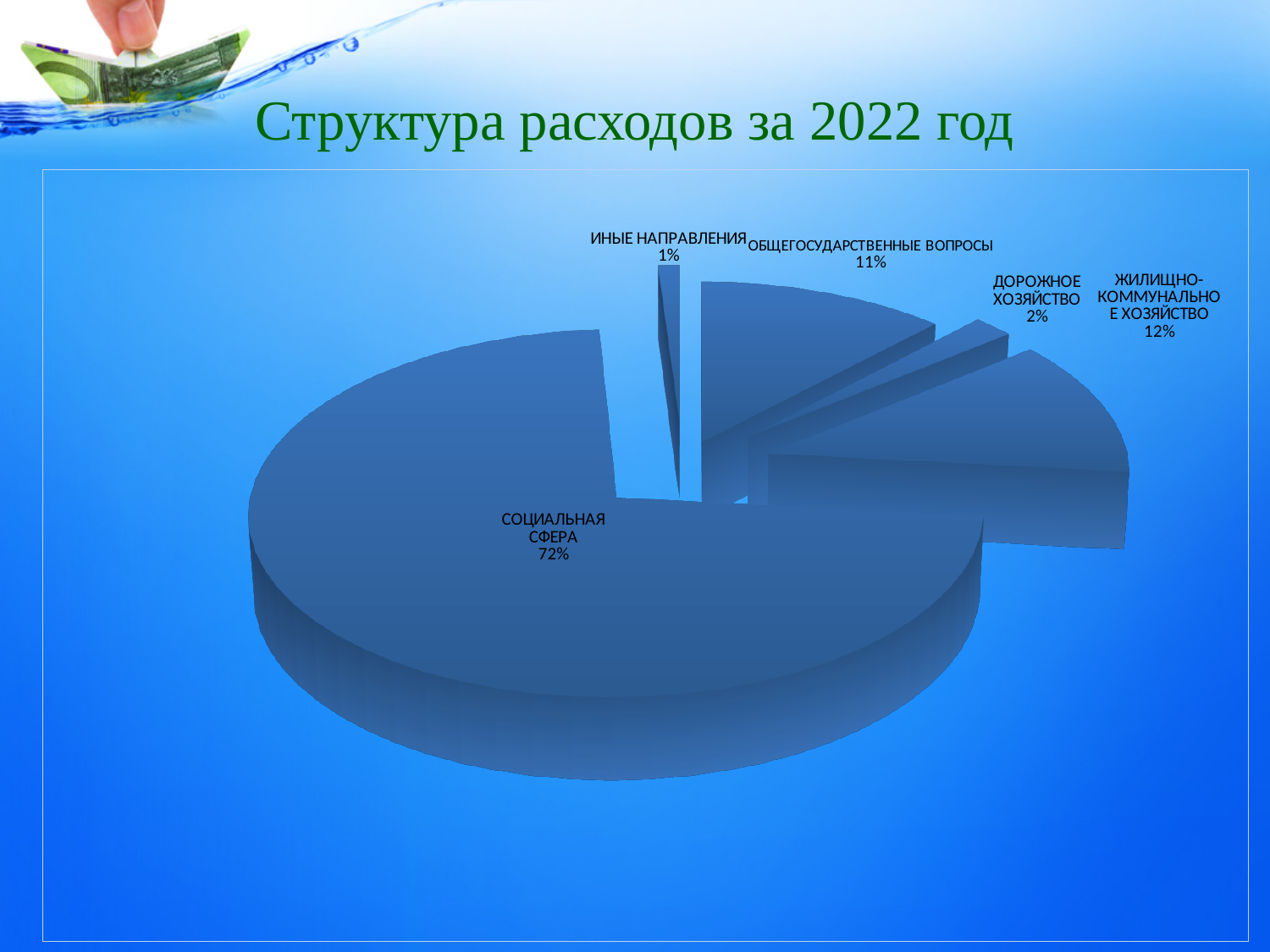
How many categories are shown in the pie chart? 5 What share of expenses does ЖИЛИЩНО-КОММУНАЛЬНОЕ ХОЗЯЙСТВО account for? 12% Which category has the smallest share of expenses? ИНЫЕ НАПРАВЛЕНИЯ What kind of chart is shown on the slide? pie chart What share of expenses does ИНЫЕ НАПРАВЛЕНИЯ account for? 1% What is the title of the slide containing the chart? Структура расходов за 2022 год What share of expenses does ОБЩЕГОСУДАРСТВЕННЫЕ ВОПРОСЫ account for? 11% Which is larger, the share for ОБЩЕГОСУДАРСТВЕННЫЕ ВОПРОСЫ or for ДОРОЖНОЕ ХОЗЯЙСТВО? ОБЩЕГОСУДАРСТВЕННЫЕ ВОПРОСЫ Which category has the largest share of expenses? СОЦИАЛЬНАЯ СФЕРА What is the difference in percentage points between СОЦИАЛЬНАЯ СФЕРА and ЖИЛИЩНО-КОММУНАЛЬНОЕ ХОЗЯЙСТВО? 60